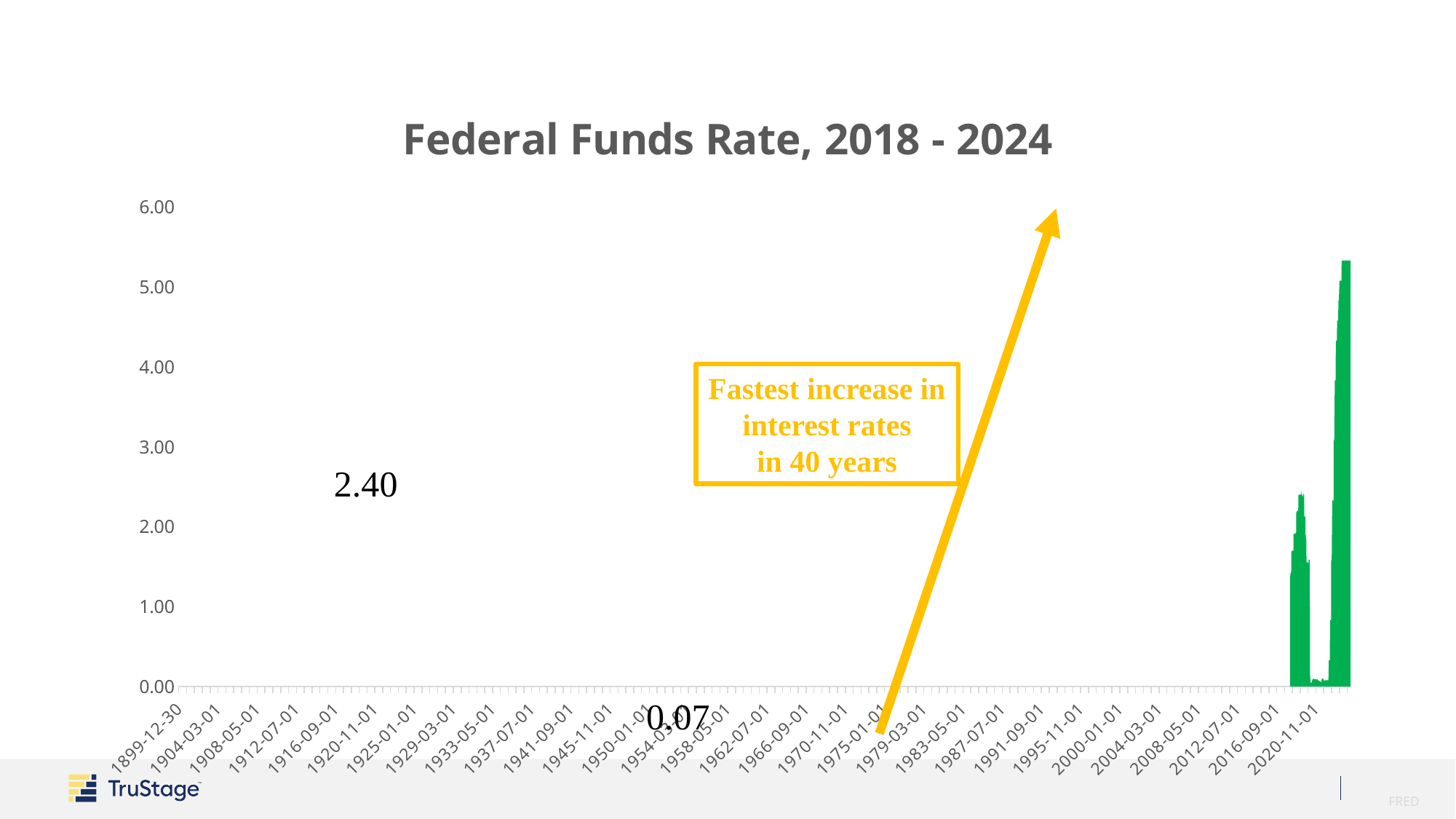
Is the peak reached around 2019 greater or less than 3.00? less What does the annotation box on the chart say? Fastest increase in interest rates in 40 years Is the lowest value plotted on the chart greater or less than 1.00? less What kind of chart is shown on the slide? bar chart Is the peak reached around 2019 greater or less than 2.00? greater Do the plotted values rise or fall over the final years shown on the chart? rise What is the title of the chart? Federal Funds Rate, 2018 - 2024 Which is higher: the peak reached around 2019 or the peak reached after 2022? the peak after 2022